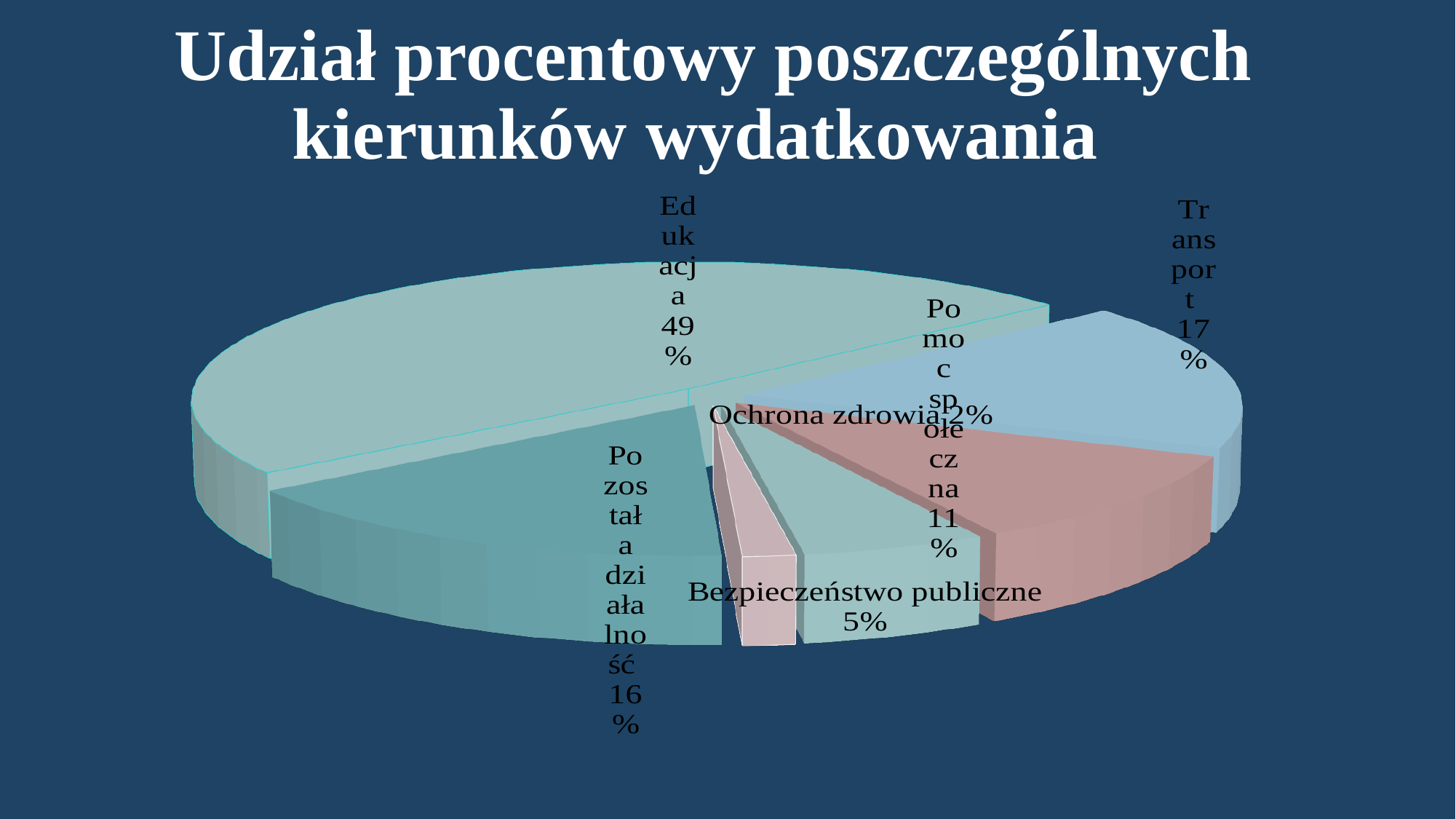
What percentage share does Ochrona zdrowia have in the pie chart? 2% Which category has the smallest share of the pie chart? Ochrona zdrowia What is the difference in percentage points between the shares of Edukacja and Transport? 32 What percentage share does Transport have in the pie chart? 17% Which has a larger share, Pomoc społeczna or Bezpieczeństwo publiczne? Pomoc społeczna How many categories are shown in the pie chart? 6 What percentage share does Pozostała działalność have in the pie chart? 16% What type of chart is shown on the slide? Pie chart What percentage share does Bezpieczeństwo publiczne have in the pie chart? 5% Which category has the largest share of the pie chart? Edukacja What percentage share does Edukacja have in the pie chart? 49% What percentage share does Pomoc społeczna have in the pie chart? 11%